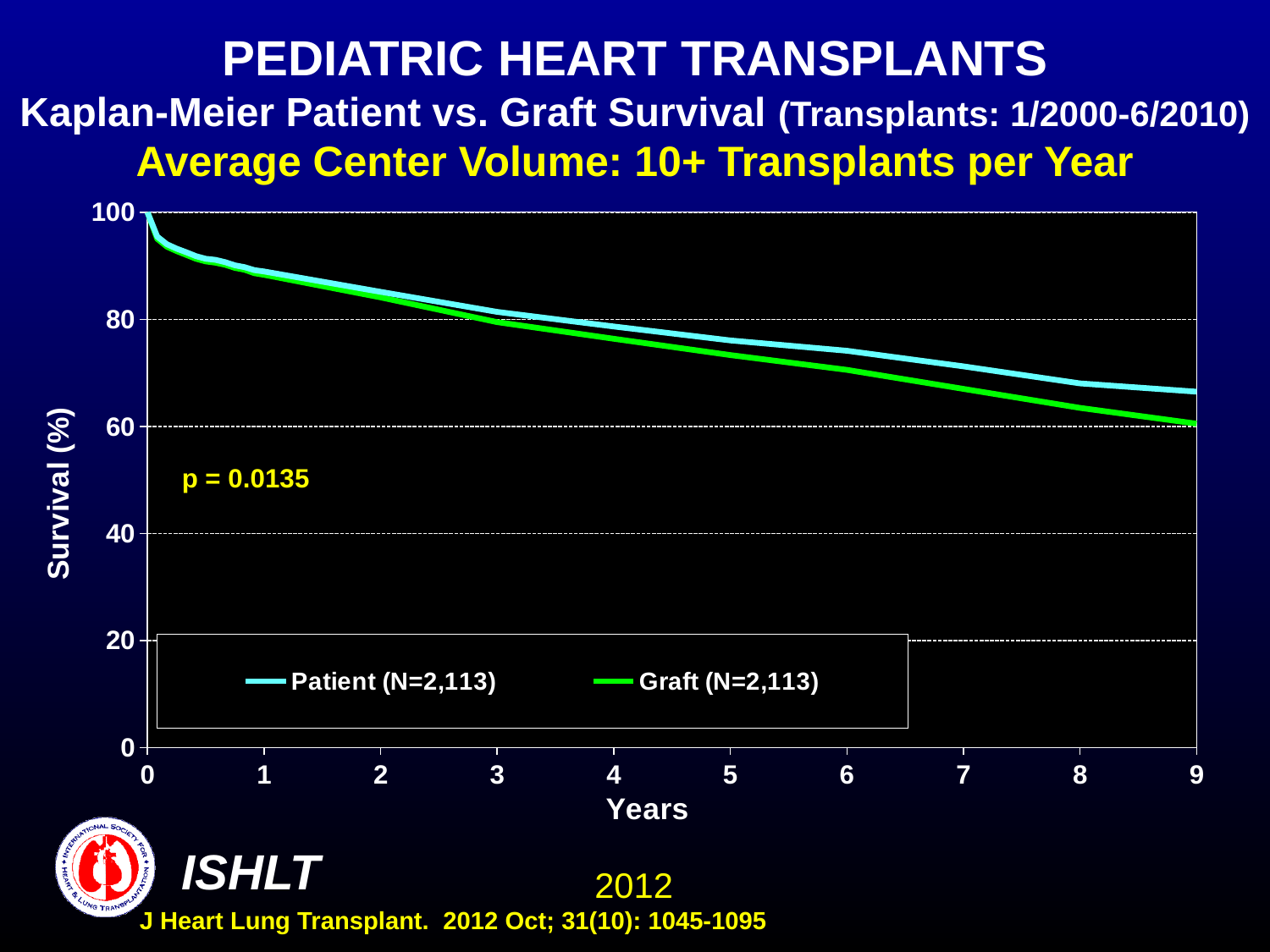
Is the Patient survival at 1 year greater or less than 80? greater What is the N given for the Graft series in the legend? N=2,113 Is the Graft survival at 7 years greater or less than 60? greater How many series does the legend list? 2 What kind of chart is shown on the slide? Line chart Is the Patient survival at 9 years greater or less than 60? greater At 9 years, which series has the higher survival, Patient or Graft? Patient What p-value is printed on the chart? p = 0.0135 Do the survival curves rise or fall as years increase? Fall